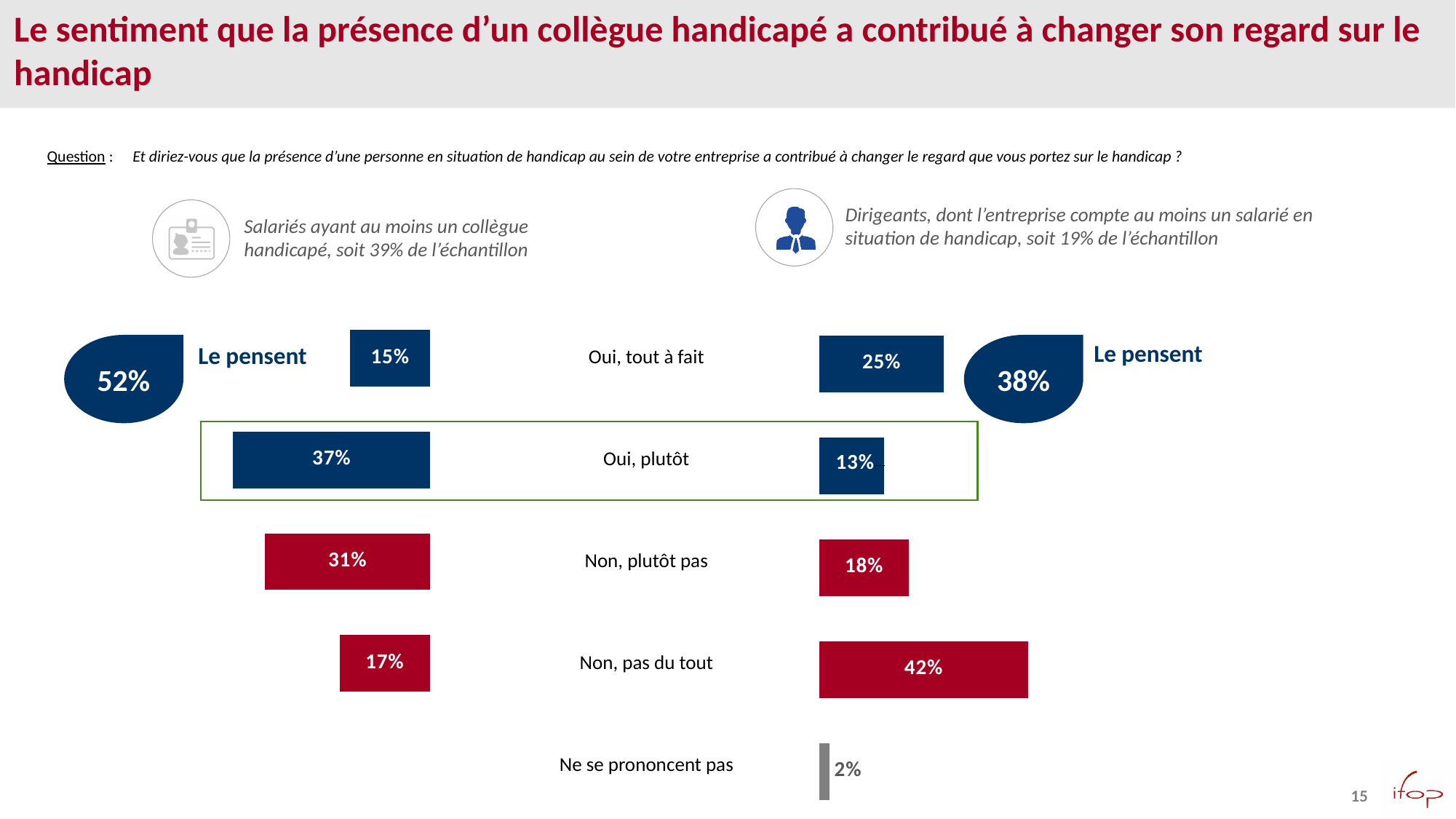
Which is larger: the "Oui, tout à fait" percentage for Salariés (left chart) or for Dirigeants (right chart)? Dirigeants What is the total share of Salariés (left chart) who think the presence of a disabled colleague changed their view ("Le pensent")? 52% In the left chart (Salariés), what percentage answered "Oui, plutôt"? 37% In the left chart (Salariés), which answer has the highest percentage? Oui, plutôt In the right chart (Dirigeants), what percentage answered "Ne se prononcent pas"? 2% In the right chart (Dirigeants), which answer has the highest percentage? Non, pas du tout How many answer categories are shown in the right chart (Dirigeants)? 5 In the right chart (Dirigeants), what percentage answered "Non, pas du tout"? 42% In the left chart (Salariés), which answer has the lowest percentage? Oui, tout à fait In the right chart (Dirigeants), which answer has the lowest percentage? Ne se prononcent pas What is the difference between the "Non, pas du tout" percentage for Dirigeants (right chart) and for Salariés (left chart)? 25 percentage points What type of chart is used on this slide? Bar chart